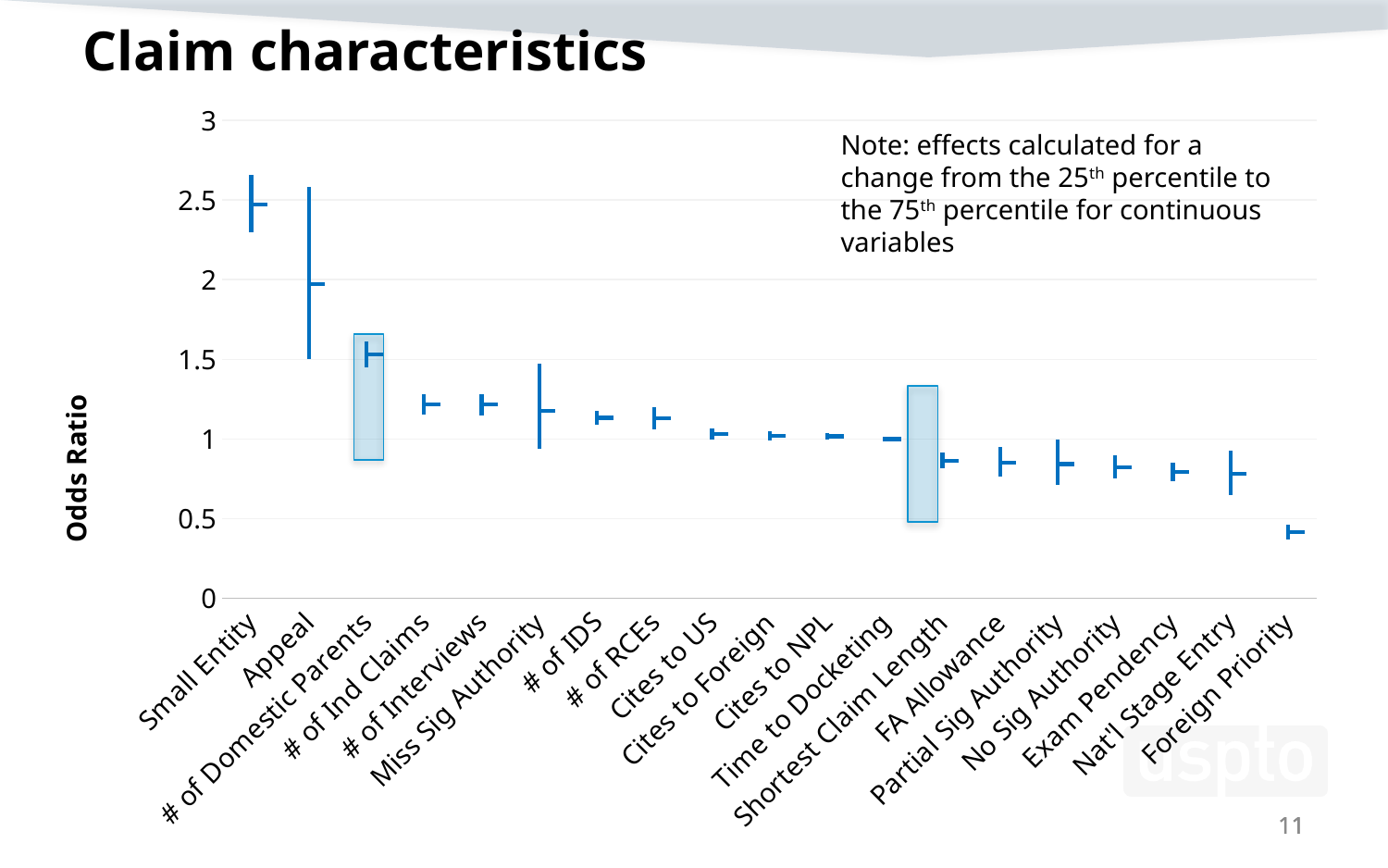
Which category has the lowest odds ratio in the chart? Foreign Priority Which category has the highest odds ratio in the chart? Small Entity Do the odds ratios generally rise or fall moving from left to right along the x axis? fall Which has a larger odds ratio, Small Entity or Foreign Priority? Small Entity Is the odds ratio for Exam Pendency greater or less than 1? less Is the odds ratio for Small Entity greater or less than 2? greater Is the odds ratio for # of Ind Claims greater or less than 1.5? less Which has a larger odds ratio, Appeal or FA Allowance? Appeal What is the label on the vertical axis of the chart? Odds Ratio How many categories are shown on the x axis of the chart? 19